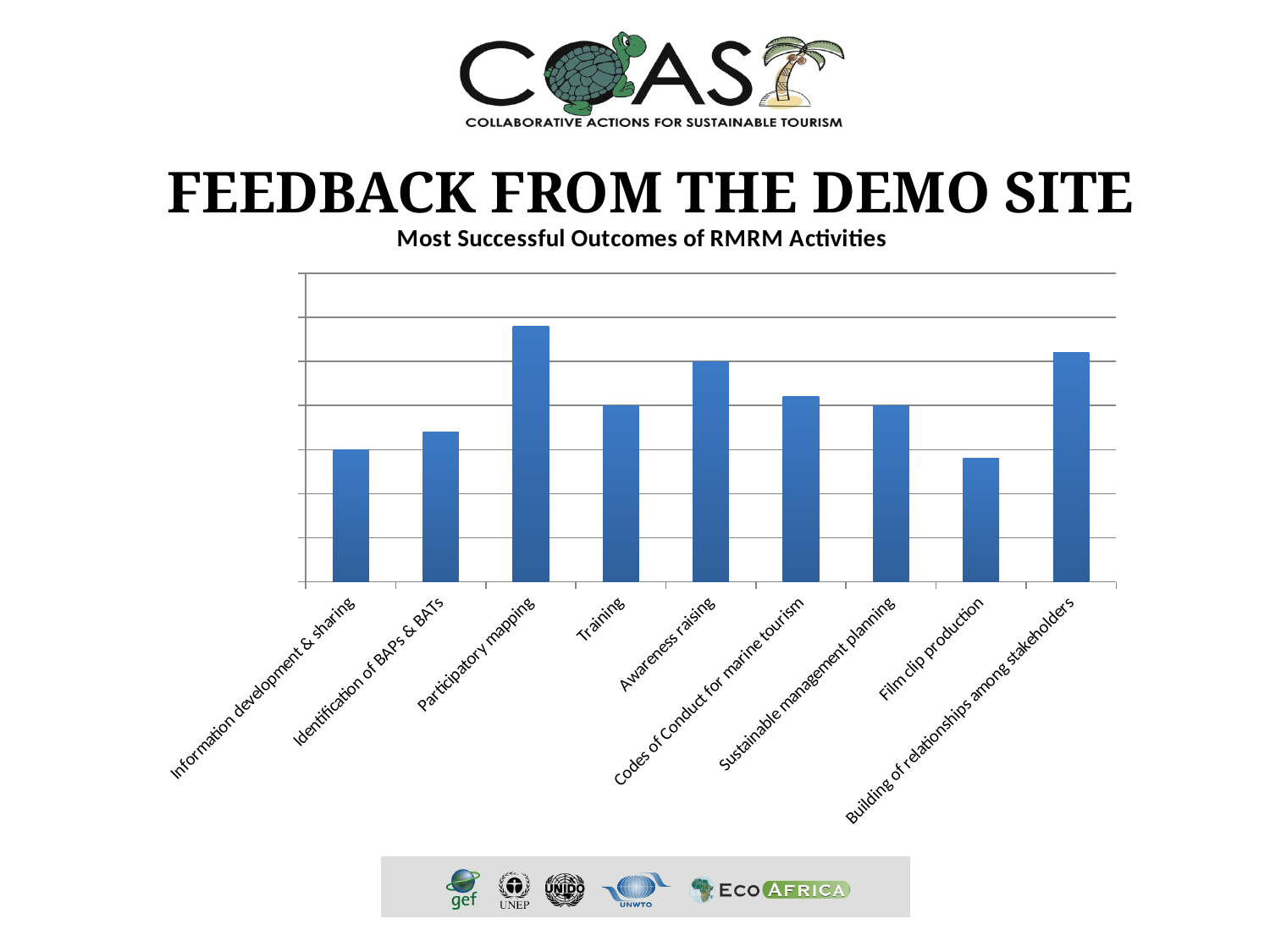
What kind of chart is shown on the slide? Bar chart Which is larger, the value for Film clip production or the value for Information development & sharing? Information development & sharing Which is larger, the value for Identification of BAPs & BATs or the value for Participatory mapping? Participatory mapping How many categories are plotted on the x axis of the chart? 9 Which category has the highest bar in the chart? Participatory mapping What colour are the bars in the chart? Blue Which category has the second highest bar in the chart? Building of relationships among stakeholders Which is larger, the value for Participatory mapping or the value for Building of relationships among stakeholders? Participatory mapping What is the title of the chart? Most Successful Outcomes of RMRM Activities Which category has the lowest bar in the chart? Film clip production